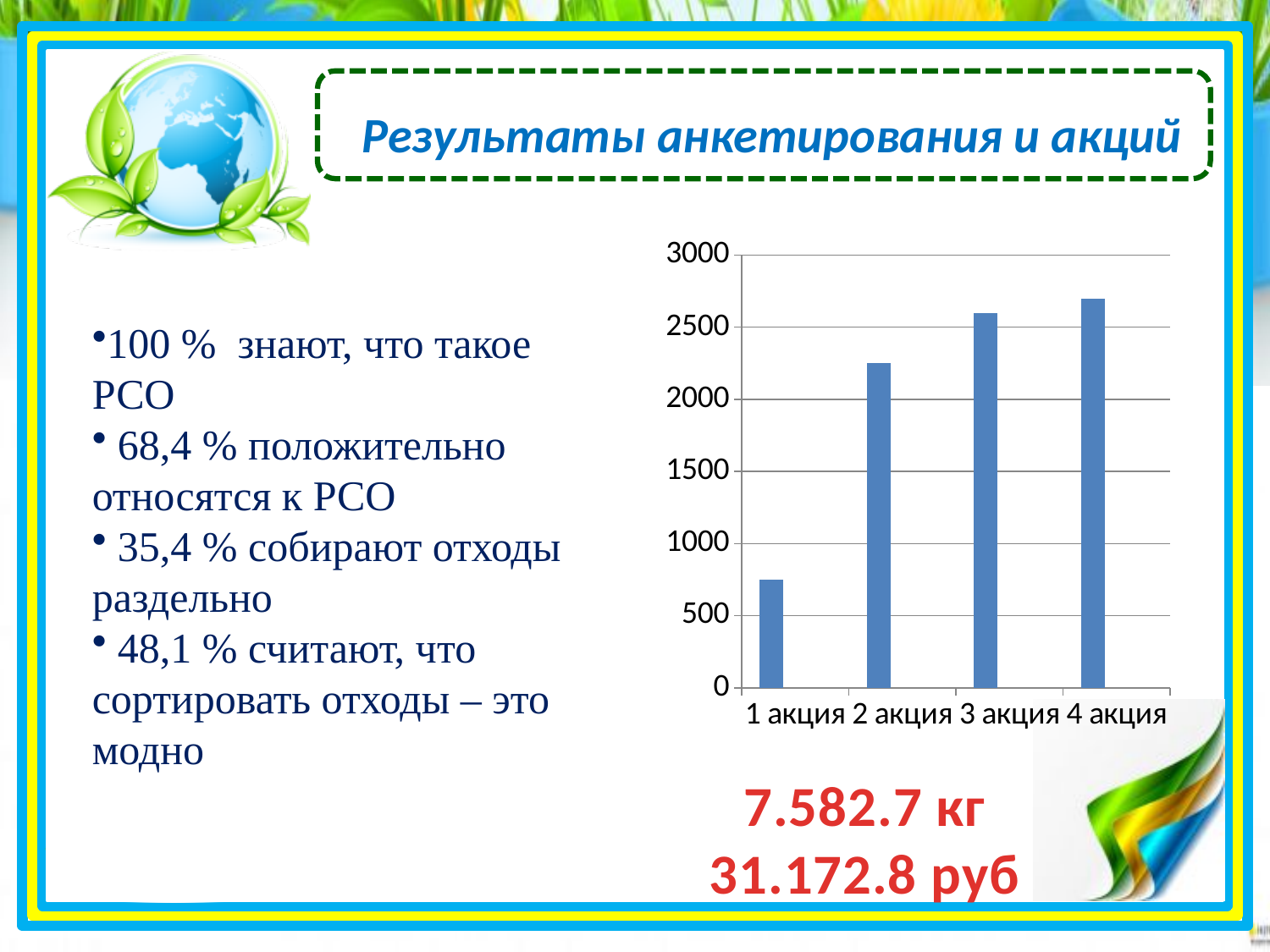
What kind of chart is shown on the slide? bar chart Which category has the lowest bar on the chart? 1 акция How many categories are plotted on the chart? 4 Is the value for 1 акция greater or less than 500? greater Is the value for 4 акция greater or less than 3000? less Which is larger, the value for 1 акция or the value for 2 акция? 2 акция Is the value for 1 акция greater or less than 1000? less Which category has the highest bar on the chart? 4 акция Do the values rise or fall from 1 акция to 4 акция? rise